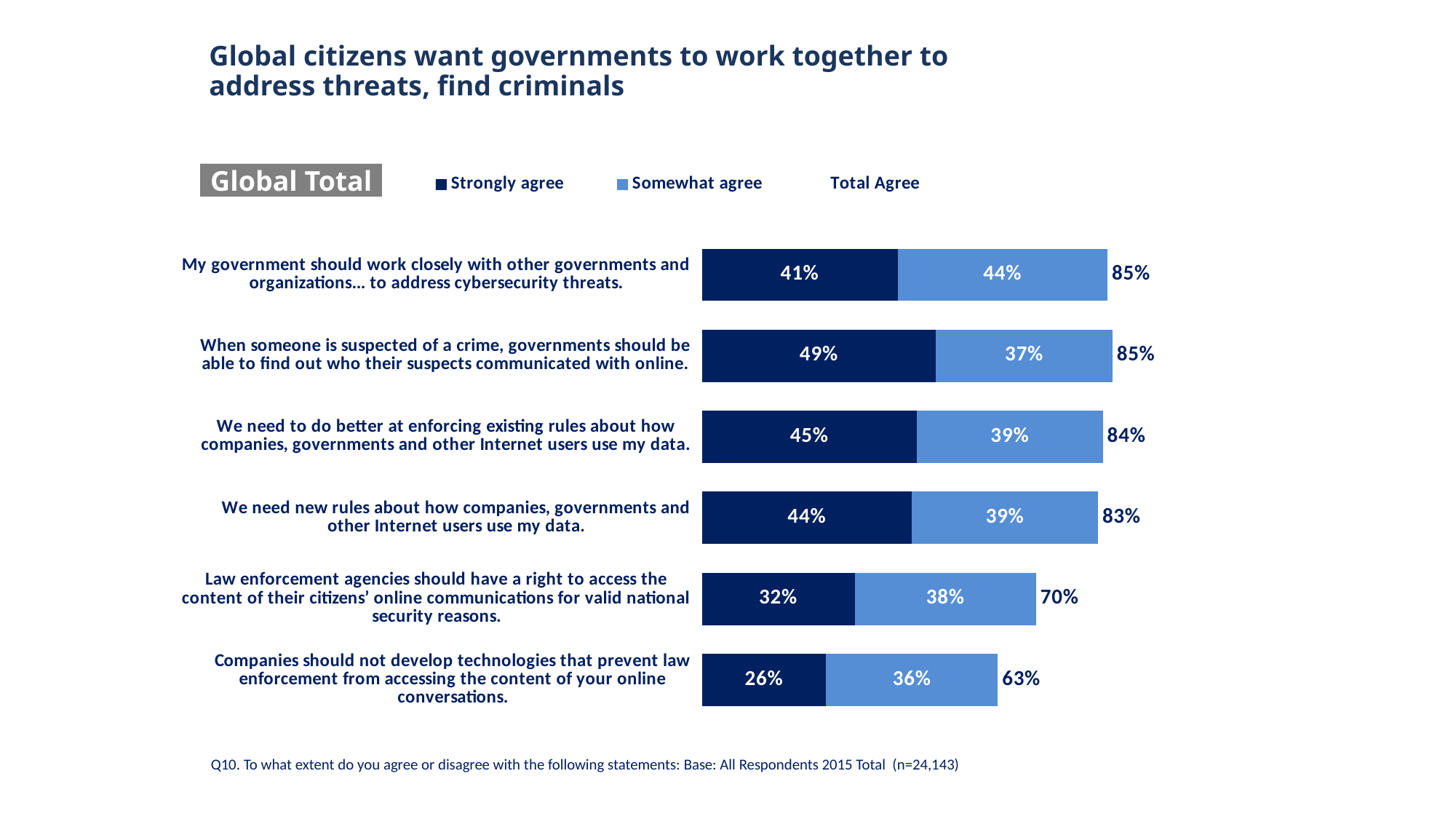
What is the Total Agree value for the statement that companies should not develop technologies that prevent law enforcement from accessing the content of online conversations? 63% What is the Total Agree value for the statement 'We need new rules about how companies, governments and other Internet users use my data'? 83% What is the Somewhat agree value for the statement 'My government should work closely with other governments and organizations... to address cybersecurity threats'? 44% Which statement has the lowest Total Agree percentage? Companies should not develop technologies that prevent law enforcement from accessing the content of your online conversations. Which colour represents Strongly agree in the chart? Dark navy blue Which statement has the highest Strongly agree percentage? When someone is suspected of a crime, governments should be able to find out who their suspects communicated with online. Which is larger: the Strongly agree value for 'We need to do better at enforcing existing rules' or the Strongly agree value for 'We need new rules'? We need to do better at enforcing existing rules What percentage of respondents strongly agree that governments should be able to find out who suspects communicated with online when someone is suspected of a crime? 49% How many statements are shown in the chart? 6 What is the difference between the Strongly agree and Somewhat agree values for the statement about law enforcement agencies having a right to access the content of citizens' online communications? 6% What kind of chart is shown on the slide? Stacked bar chart How many series does the legend list? 3